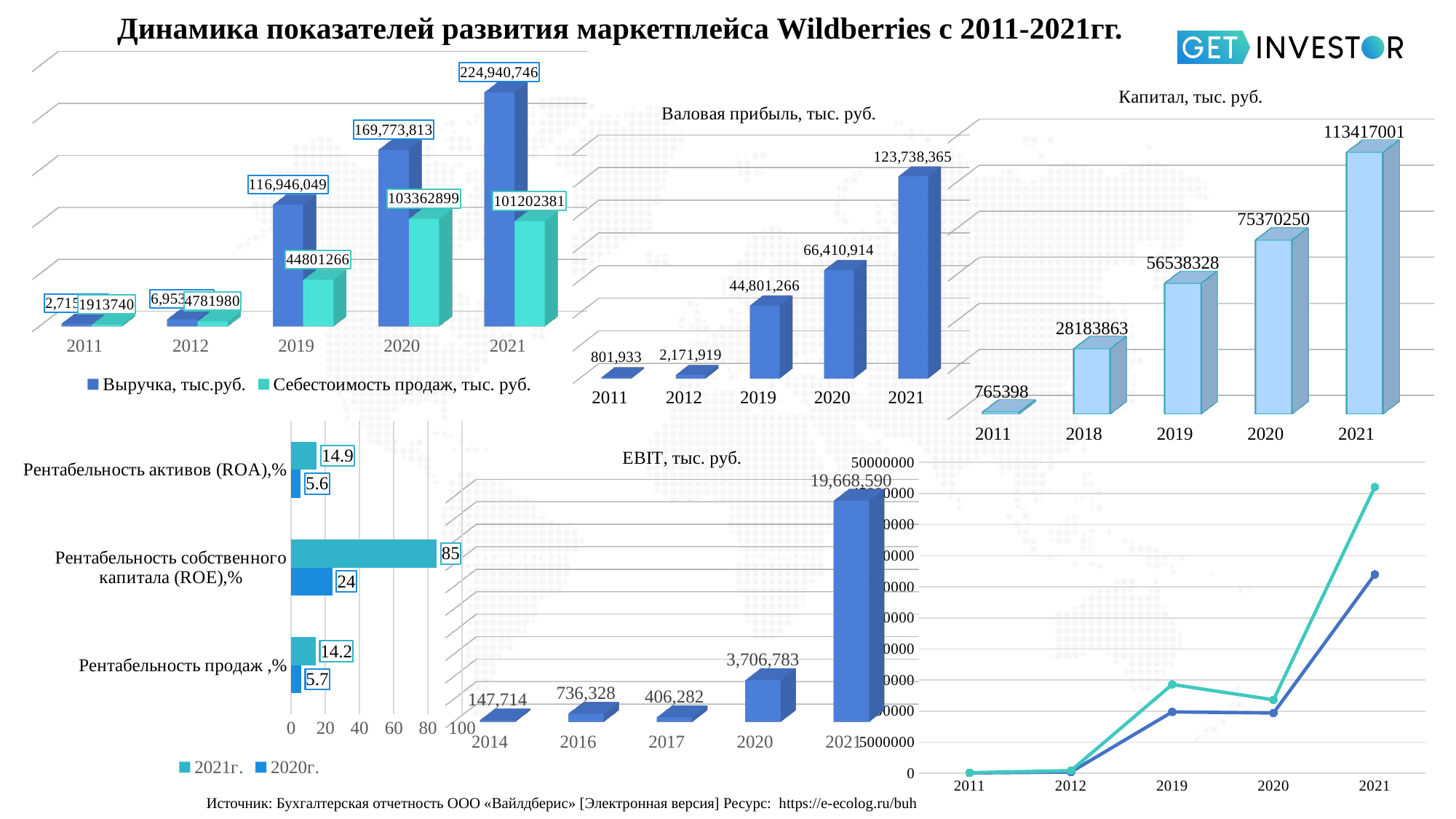
In the top-left chart, what is the Себестоимость продаж value for 2020? 103362899 In the 'Валовая прибыль, тыс. руб.' chart, what is the value for 2021? 123,738,365 In the 'EBIT, тыс. руб.' chart, which is larger, the value for 2016 or the value for 2017? 2016 In the top-left chart with the legend 'Выручка, тыс.руб.' and 'Себестоимость продаж, тыс. руб.', what is the Выручка value for 2021? 224,940,746 In the 'Капитал, тыс. руб.' chart, what is the value for 2019? 56538328 In the bottom-left horizontal bar chart, what is the 2021г. value for Рентабельность собственного капитала (ROE),%? 85 In the 'Капитал, тыс. руб.' chart, how many years are shown on the x axis? 5 In the bottom-left horizontal bar chart, what is the difference between the 2021г. and 2020г. values for Рентабельность активов (ROA),%? 9.3 In the 'EBIT, тыс. руб.' chart, which year has the lowest value? 2014 In the 'EBIT, тыс. руб.' chart, what is the value for 2020? 3,706,783 In the 'Валовая прибыль, тыс. руб.' chart, what is the value for 2011? 801,933 In the 'Капитал, тыс. руб.' chart, which year has the highest value? 2021